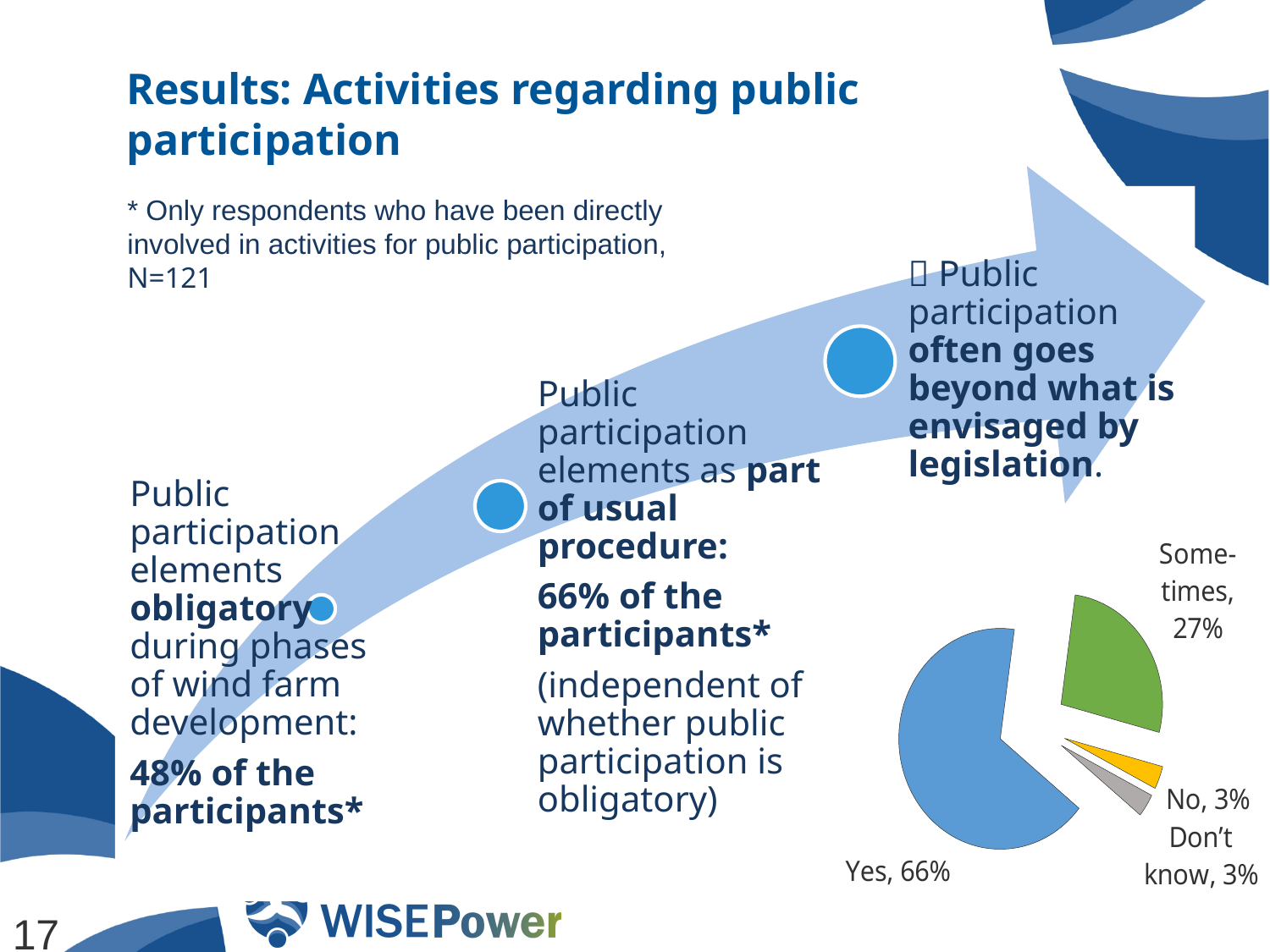
What is the difference in percentage points between the "Yes" slice and the "Sometimes" slice? 39 What colour is the "Yes" slice in the pie chart? blue What colour is the "Sometimes" slice in the pie chart? green Which slice of the pie chart is the largest? Yes How many slices does the pie chart have? 4 What kind of chart is shown on the slide? pie chart What share of the pie chart is labelled "Don't know"? 3% What share of the pie chart is labelled "Sometimes"? 27% What share of the pie chart is labelled "Yes"? 66% What is the combined share of the "No" and "Don't know" slices in the pie chart? 6% Which is larger in the pie chart, the "Sometimes" slice or the "No" slice? Sometimes What share of the pie chart is labelled "No"? 3%